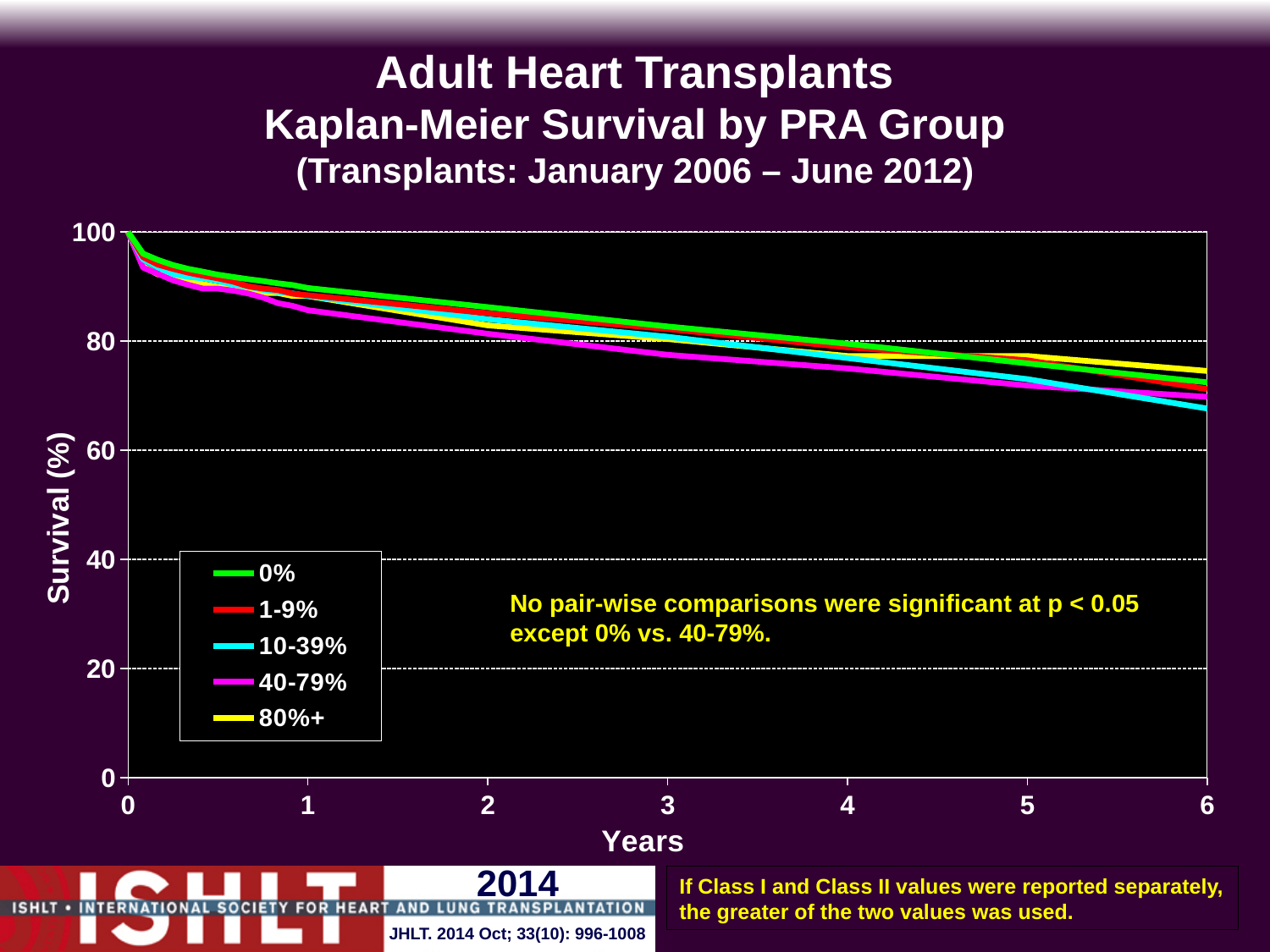
Is the survival value for the 10-39% group at 6 years greater or less than 60? greater Is the survival value for the 80%+ group at 6 years greater or less than 80? less What kind of chart is shown on the slide? Line chart Is the survival value for the 40-79% group at 3 years greater or less than 80? less Which PRA groups are listed in the legend? 0%, 1-9%, 10-39%, 40-79%, 80%+ Do the survival curves rise or fall as years increase? Fall What is the label of the y axis? Survival (%) How many PRA groups (series) does the legend list? 5 At 2 years, which group has higher survival: 0% or 40-79%? 0% Which PRA group has the lowest survival at 2 years? 40-79% Which PRA group has the lowest survival at 6 years? 10-39%